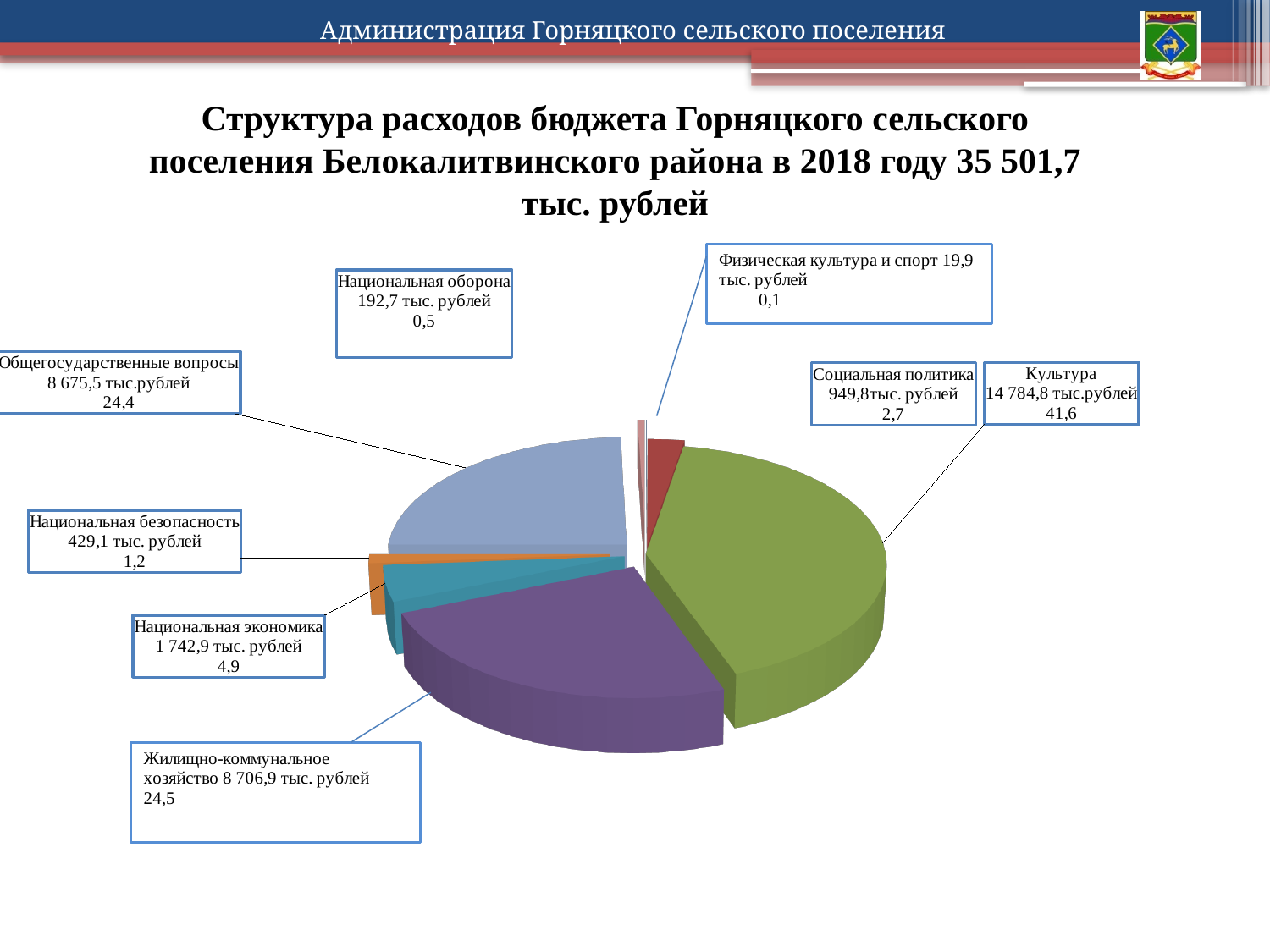
What is the value for Культура in the pie chart? 14 784,8 тыс.рублей What is the value for Жилищно-коммунальное хозяйство? 8 706,9 тыс. рублей What share of the pie does Общегосударственные вопросы account for? 24,4 What share of the pie does Культура account for? 41,6 How many categories (slices) does the pie chart show? 8 What kind of chart is shown on the slide? pie chart What is the difference between Социальная политика (949,8) and Национальная безопасность (429,1) in тыс. рублей? 520,7 Which is larger, Национальная безопасность or Национальная оборона? Национальная безопасность Which category has the smallest slice of the pie? Физическая культура и спорт What is the value for Национальная экономика? 1 742,9 тыс. рублей What total amount of expenditures is stated in the chart title for 2018? 35 501,7 тыс. рублей Which category has the largest slice of the pie? Культура